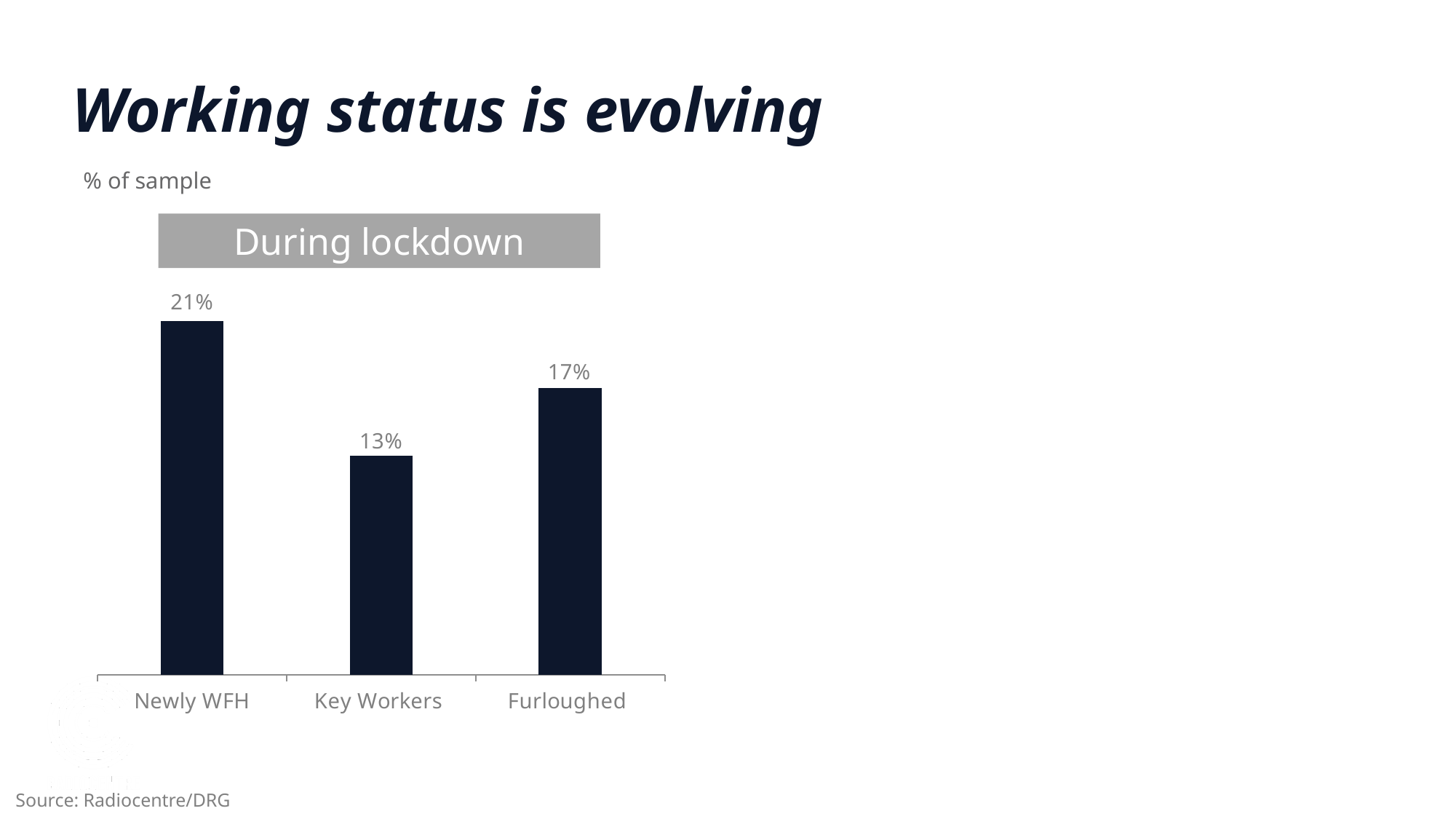
How many categories are shown in the chart? 3 Which category has the highest value? Newly WFH What kind of chart is shown on the slide? Bar chart What is the value for Newly WFH? 21% What is the label in the grey box above the bars? During lockdown What unit does the chart's axis label say the values are in? % of sample What is the value for Key Workers? 13% What is the value for Furloughed? 17% What is the difference between the values for Newly WFH and Key Workers? 8% Which is larger, the value for Furloughed or the value for Key Workers? Furloughed Which category has the lowest value? Key Workers What is the difference between the values for Furloughed and Key Workers? 4%